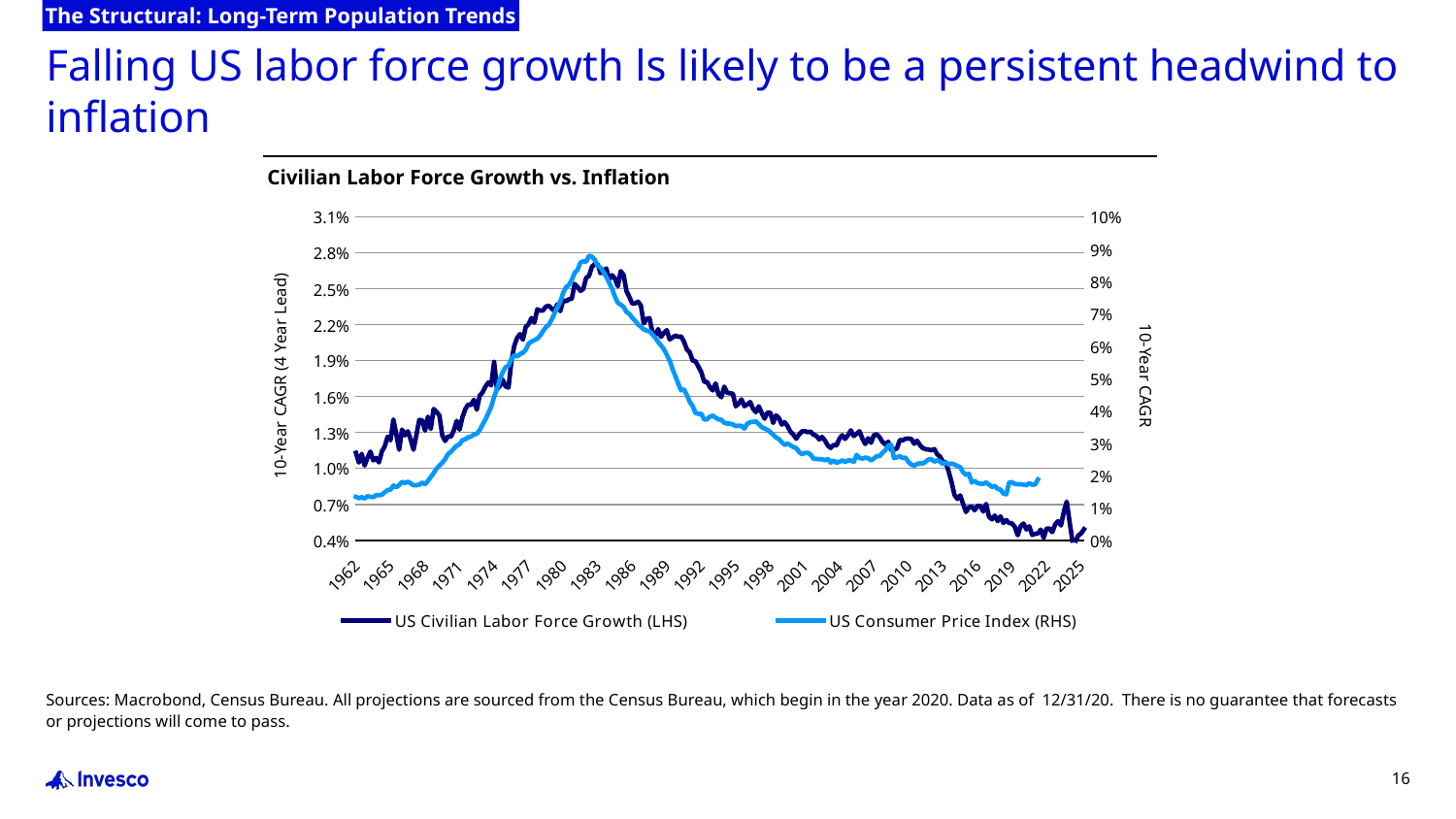
From its peak in the early 1980s to the end of the series, does the US Consumer Price Index line rise or fall? fall How many series does the legend list? 2 Is the value of the US Consumer Price Index in 1962 greater or less than 2%? less Is the value of US Civilian Labor Force Growth in 2025 greater or less than 1.0%? less Between 1962 and 1983, does the US Civilian Labor Force Growth line rise or fall? rise What kind of chart is shown on the slide? line chart Between 1983 and 2025, does the US Civilian Labor Force Growth line rise or fall? fall What is the title of the chart? Civilian Labor Force Growth vs. Inflation Is the value of US Civilian Labor Force Growth at its peak around 1983 greater or less than 2.5%? greater Which series is plotted on the right-hand axis according to the legend? US Consumer Price Index (RHS)